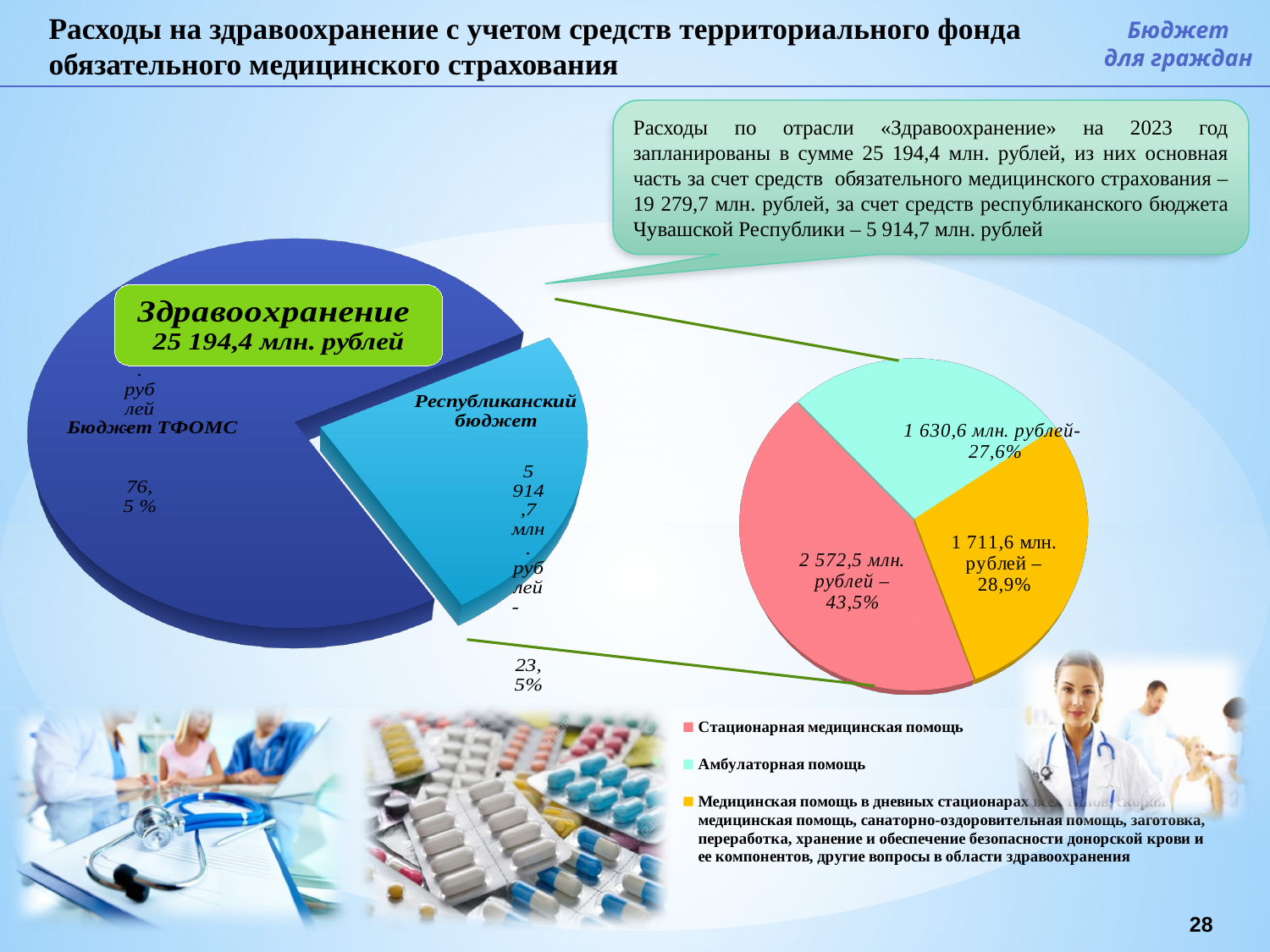
In the left pie chart, what share does Бюджет ТФОМС have? 76,5 % In the right pie chart, what share does the orange slice (Медицинская помощь в дневных стационарах...) have? 28,9% In the right pie chart, which category has the smallest slice? Амбулаторная помощь In the right pie chart, what value is shown for Стационарная медицинская помощь? 2 572,5 млн. рублей In the right pie chart, what share does Амбулаторная помощь have? 27,6% How many slices does the right pie chart have? 3 In the right pie chart, what colour is the slice for Амбулаторная помощь? light cyan What type of chart is the left chart on the slide? pie chart In the right pie chart, which category has the largest slice? Стационарная медицинская помощь In the left pie chart, what value is shown for Республиканский бюджет? 5 914,7 млн. рублей In the left pie chart, which slice is larger: Бюджет ТФОМС or Республиканский бюджет? Бюджет ТФОМС